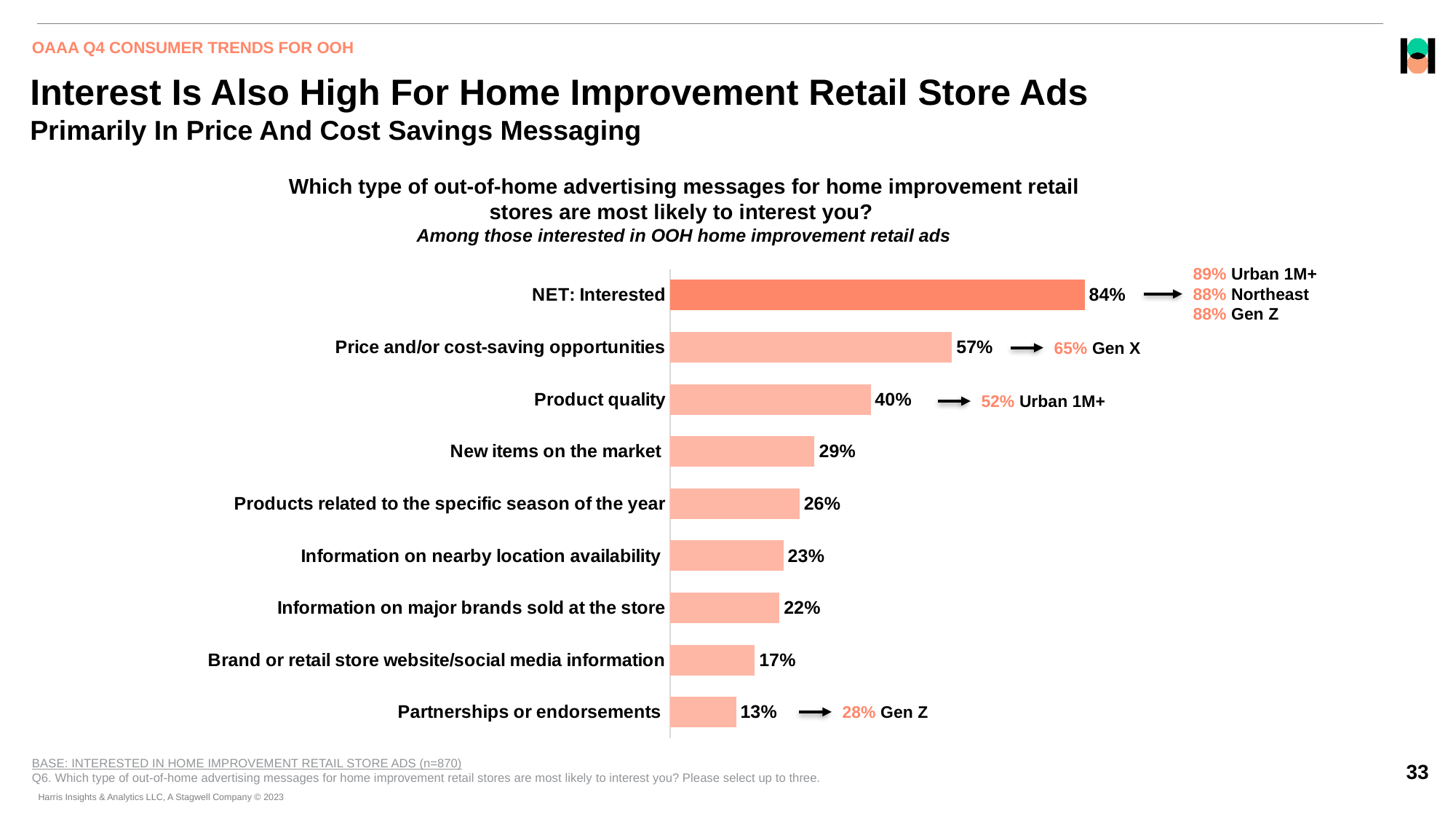
What is the value for Information on nearby location availability? 23% What is the difference between New items on the market and Brand or retail store website/social media information? 12% What is the value for NET: Interested? 84% Which is larger: Products related to the specific season of the year or Information on major brands sold at the store? Products related to the specific season of the year What is the value for Product quality? 40% What is the value for Price and/or cost-saving opportunities? 57% Excluding NET: Interested, which message type has the highest value? Price and/or cost-saving opportunities Which category has the lowest value? Partnerships or endorsements How many categories are shown in the chart? 9 What is the difference between Price and/or cost-saving opportunities and Product quality? 17% What percentage of Gen Z is shown next to Partnerships or endorsements? 28% What kind of chart is shown on the slide? Bar chart